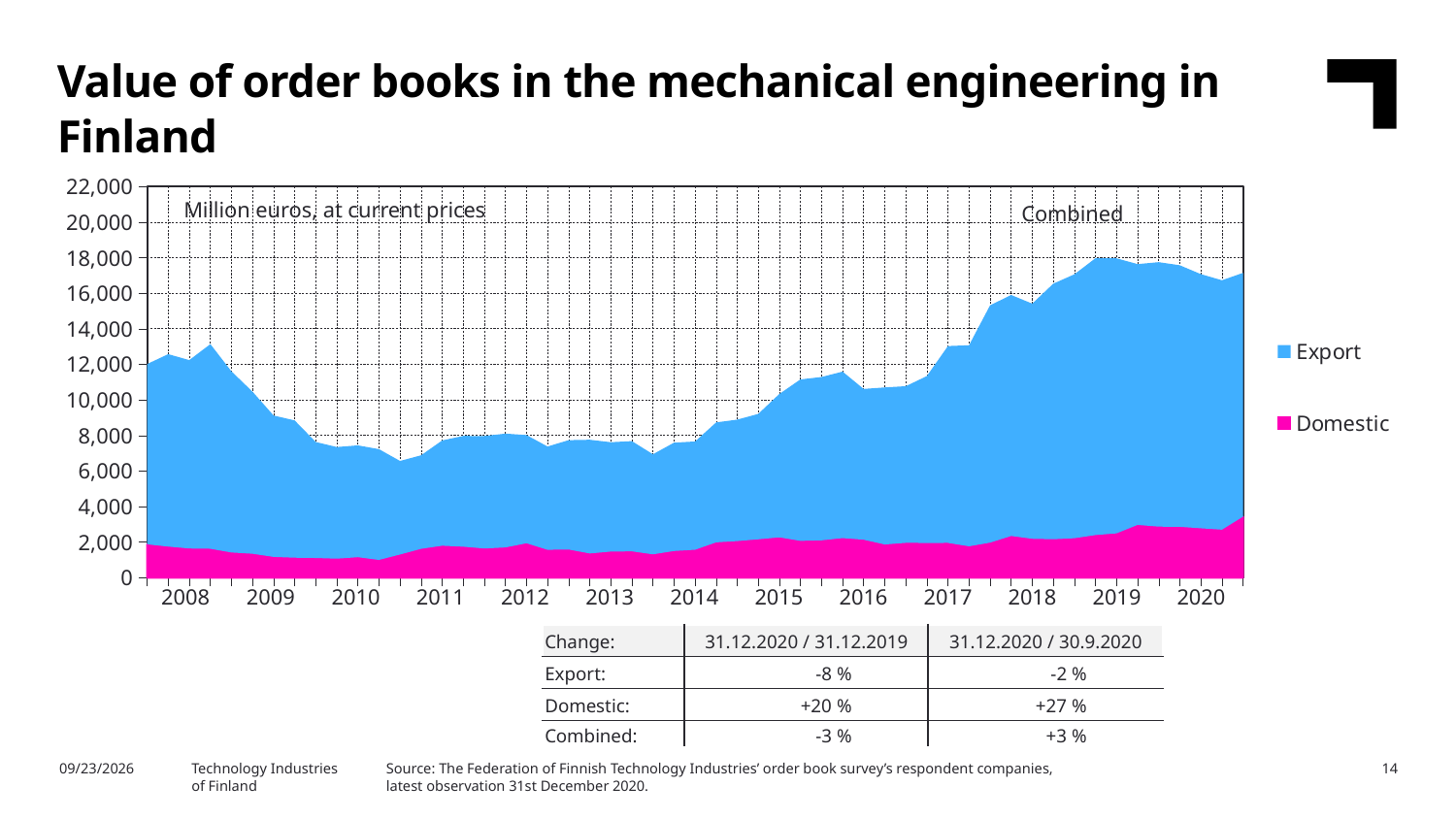
Does the combined value of order books rise or fall between 2008 and 2010? fall Is the Domestic value at the end of 2020 greater or less than 2,000? greater How many years are labelled on the x axis of the chart? 13 Does the combined value of order books rise or fall between 2016 and 2019? rise Is the combined value of order books at the start of 2019 greater or less than 16,000? greater Is the combined value of order books in 2013 greater or less than 10,000? less According to the table below the chart, what is the change in Domestic order books for 31.12.2020 / 31.12.2019? +20 % What unit is stated for the values in the chart? Million euros, at current prices How many series does the legend list? 2 Which two series are listed in the chart legend? Export and Domestic What kind of chart is shown on the slide? Area chart